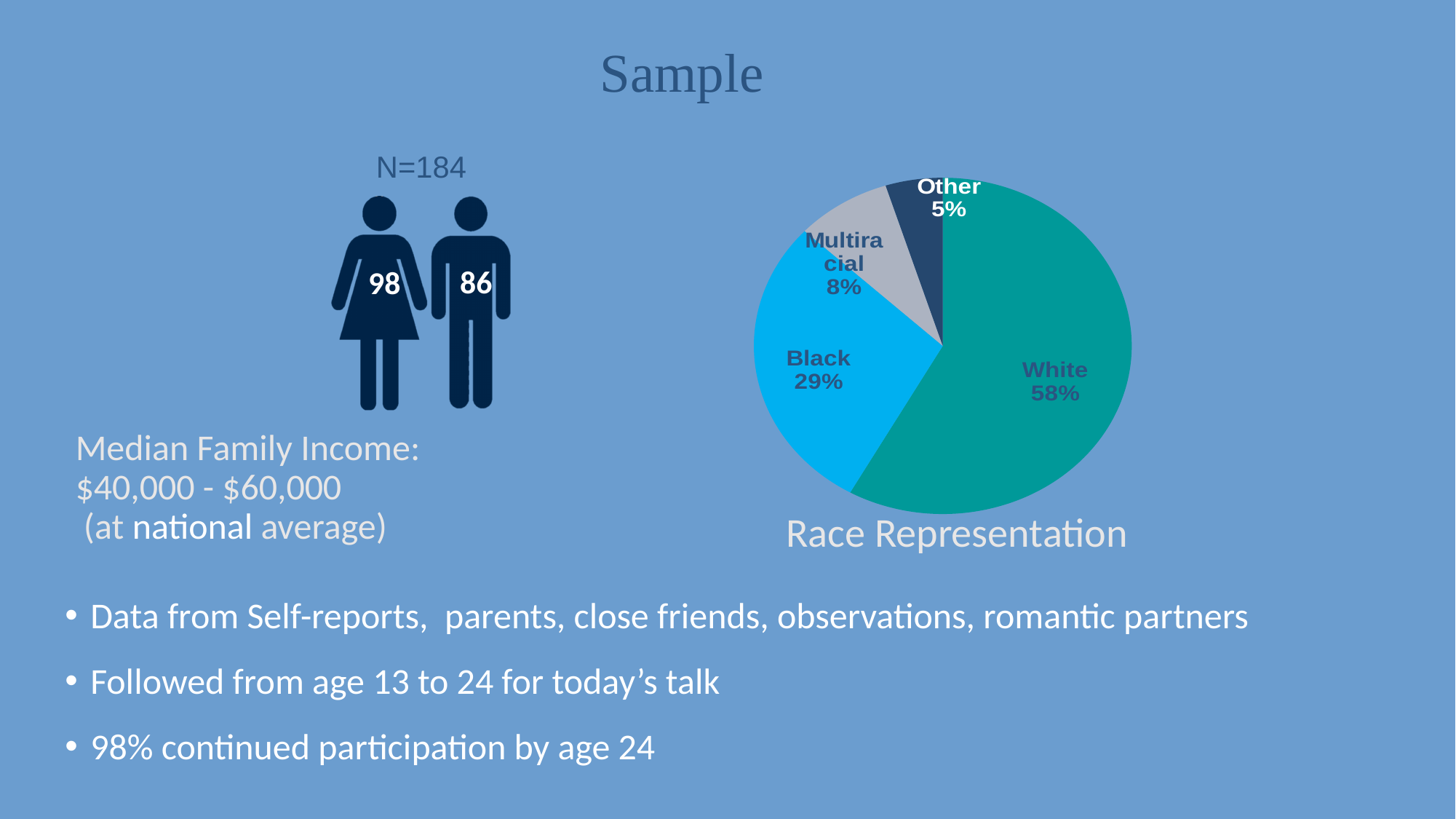
What kind of chart is the Race Representation chart? pie chart Which category has the largest slice in the Race Representation pie? White Which category has the smallest slice in the Race Representation pie? Other What share of the Race Representation pie is Multiracial? 8% In the Race Representation pie, what is the difference in percentage points between White and Black? 29 What share of the Race Representation pie is Other? 5% What share of the Race Representation pie is White? 58% How many slices does the Race Representation pie chart have? 4 What is the title shown below the pie chart? Race Representation In the Race Representation pie, what is the difference in percentage points between Multiracial and Other? 3 In the Race Representation pie, which is larger, Multiracial or Other? Multiracial